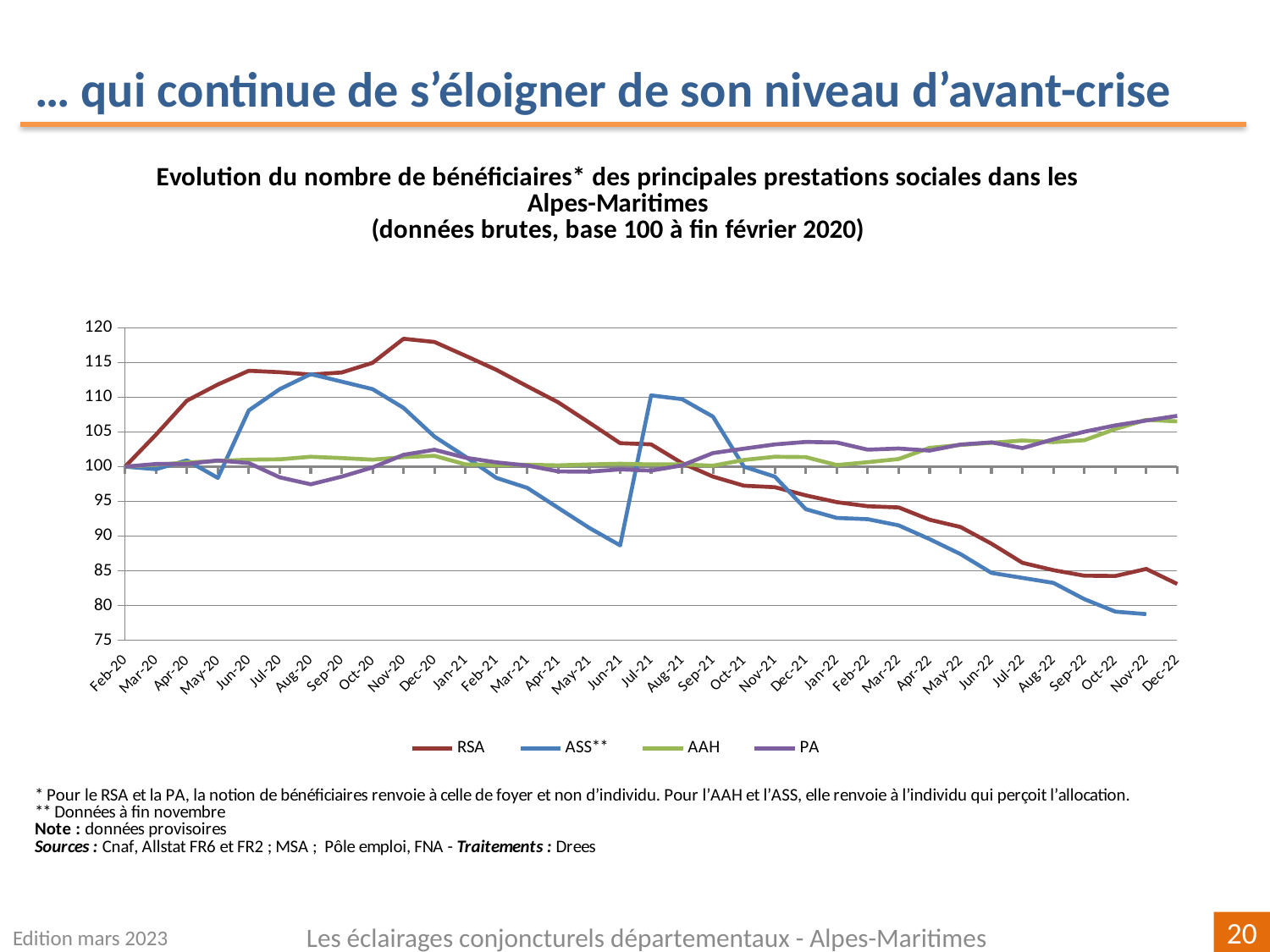
Which series has the lowest value at Nov-22? ASS** Does the RSA series rise or fall between Nov-20 and Dec-22? fall Which series has the highest value at Nov-20? RSA Is the value for PA at Dec-22 greater or less than 105? greater Is the value for ASS** at Nov-22 greater or less than 80? less What kind of chart is shown on the slide? line chart Is the value for RSA at Jun-22 greater or less than 90? less Which series are listed in the legend? RSA, ASS**, AAH, PA How many monthly points are shown on the x axis, from Feb-20 to Dec-22? 35 How many series does the legend list? 4 At Jul-21, which is larger, the value for ASS** or the value for RSA? ASS**